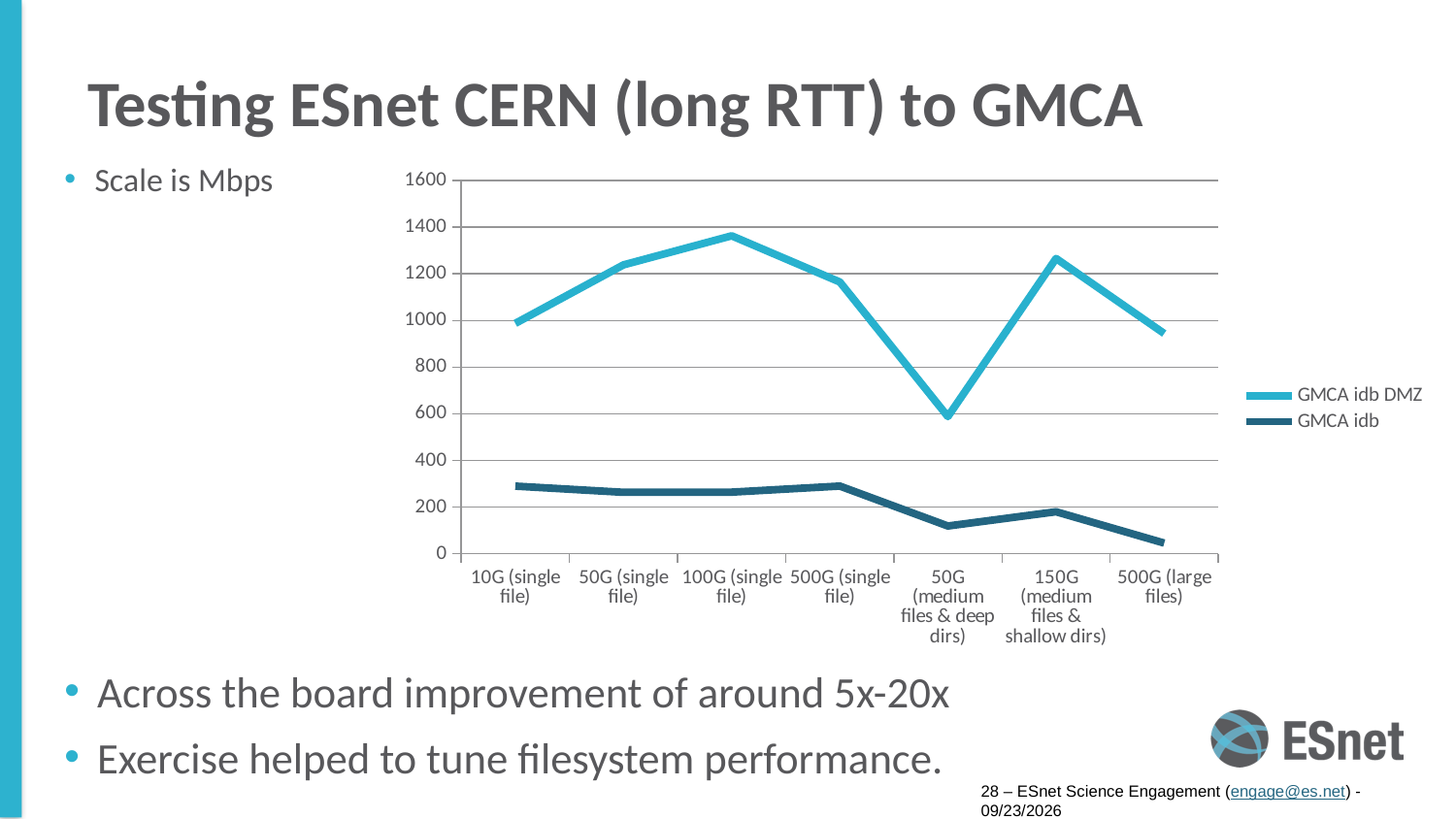
How many series does the chart legend list? 2 According to the slide, what unit is the chart's scale in? Mbps Does the GMCA idb DMZ series rise or fall between 500G (single file) and 50G (medium files & deep dirs)? fall Is the GMCA idb value for 10G (single file) greater or less than 400? less For which category does the GMCA idb series have its lowest value? 500G (large files) Is the GMCA idb DMZ value for 50G (medium files & deep dirs) greater or less than 800? less For which category does the GMCA idb DMZ series reach its highest value? 100G (single file) Which series has the larger value for 150G (medium files & shallow dirs), GMCA idb DMZ or GMCA idb? GMCA idb DMZ Is the GMCA idb DMZ value for 100G (single file) greater or less than 1200? greater How many categories are plotted along the x axis of the chart? 7 What kind of chart is shown on the slide? line chart For which category does the GMCA idb DMZ series have its lowest value? 50G (medium files & deep dirs)